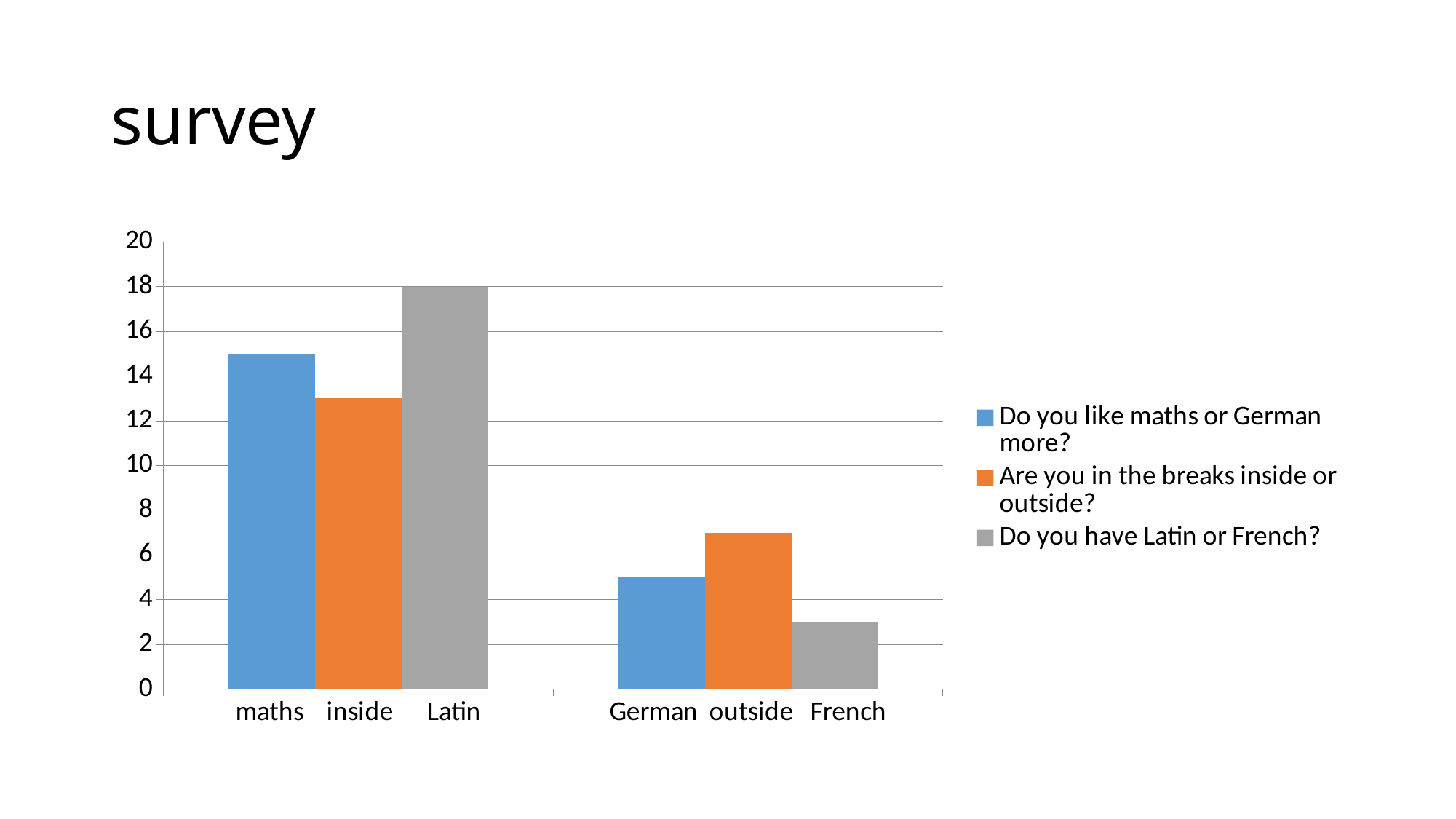
Which bar is taller, German or outside? outside What is the value of the Latin bar? 18 Is the value for French greater or less than 4? less What kind of chart is shown on the slide? bar chart Which category has the highest bar? Latin Which bar is taller, maths or inside? maths How many series does the legend list? 3 Is the value for German greater or less than 6? less Which legend entry is shown in grey? Do you have Latin or French? How many category labels are shown on the x axis? 6 Which category has the lowest bar? French Is the value for maths greater or less than 14? greater